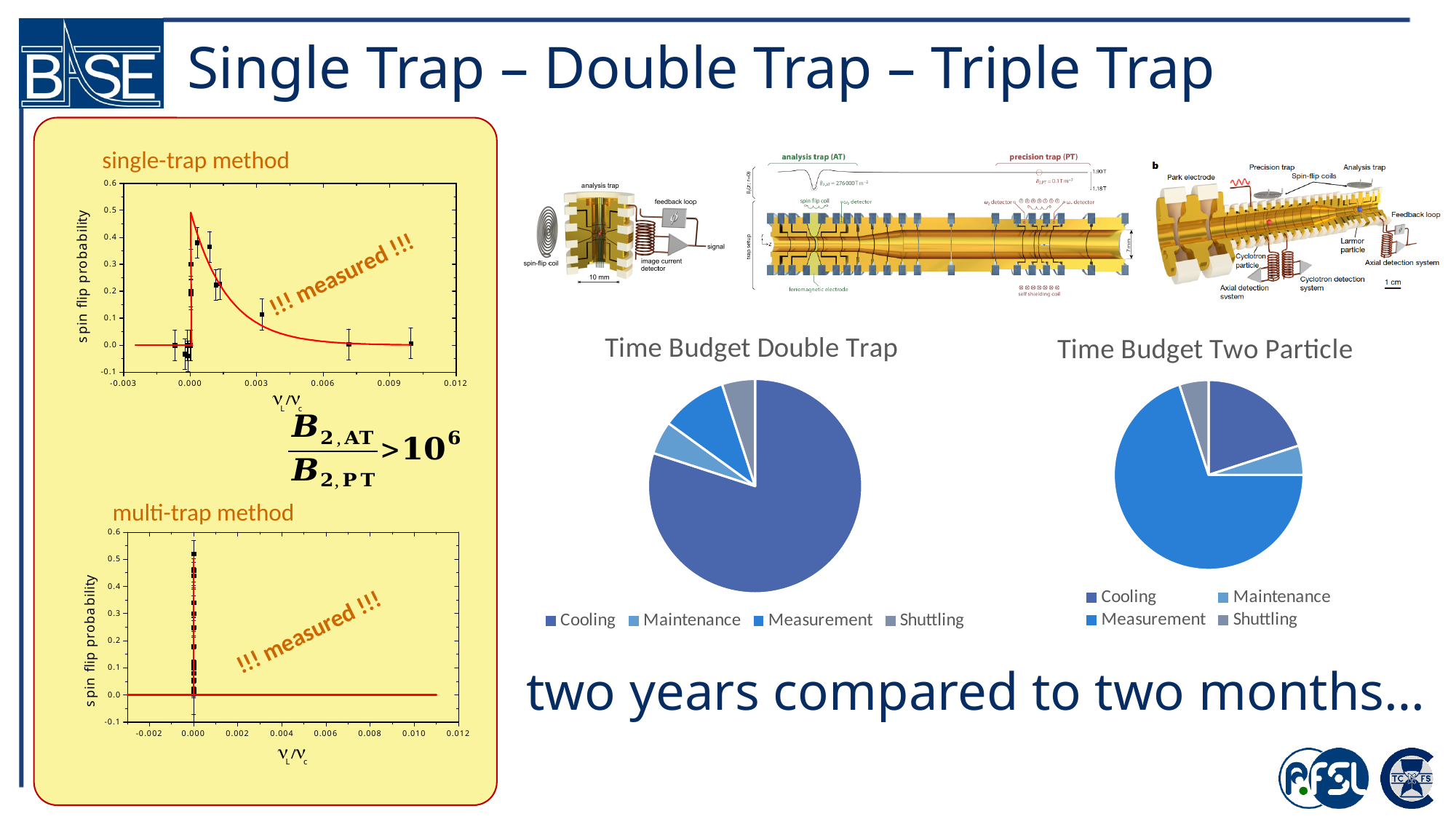
In the 'Time Budget Double Trap' chart, which category takes the largest share of the pie? Cooling In the 'Time Budget Two Particle' chart, which category takes the largest share of the pie? Measurement How many categories does the legend of the 'Time Budget Double Trap' chart list? 4 In the 'Time Budget Two Particle' chart, which is larger, the Cooling slice or the Shuttling slice? Cooling In the 'Time Budget Double Trap' chart, which is larger, the Cooling slice or the Measurement slice? Cooling How many categories does the legend of the 'Time Budget Two Particle' chart list? 4 In the 'Time Budget Two Particle' chart, which is larger, the Cooling slice or the Measurement slice? Measurement What is the y-axis label of the 'single-trap method' chart on the left? spin flip probability In the 'Time Budget Double Trap' chart, is the Cooling share greater or less than 50%? greater What are the four legend entries of the 'Time Budget Double Trap' chart? Cooling, Maintenance, Measurement, Shuttling What kind of chart is the 'Time Budget Two Particle' chart? pie chart What kind of chart is the 'Time Budget Double Trap' chart? pie chart